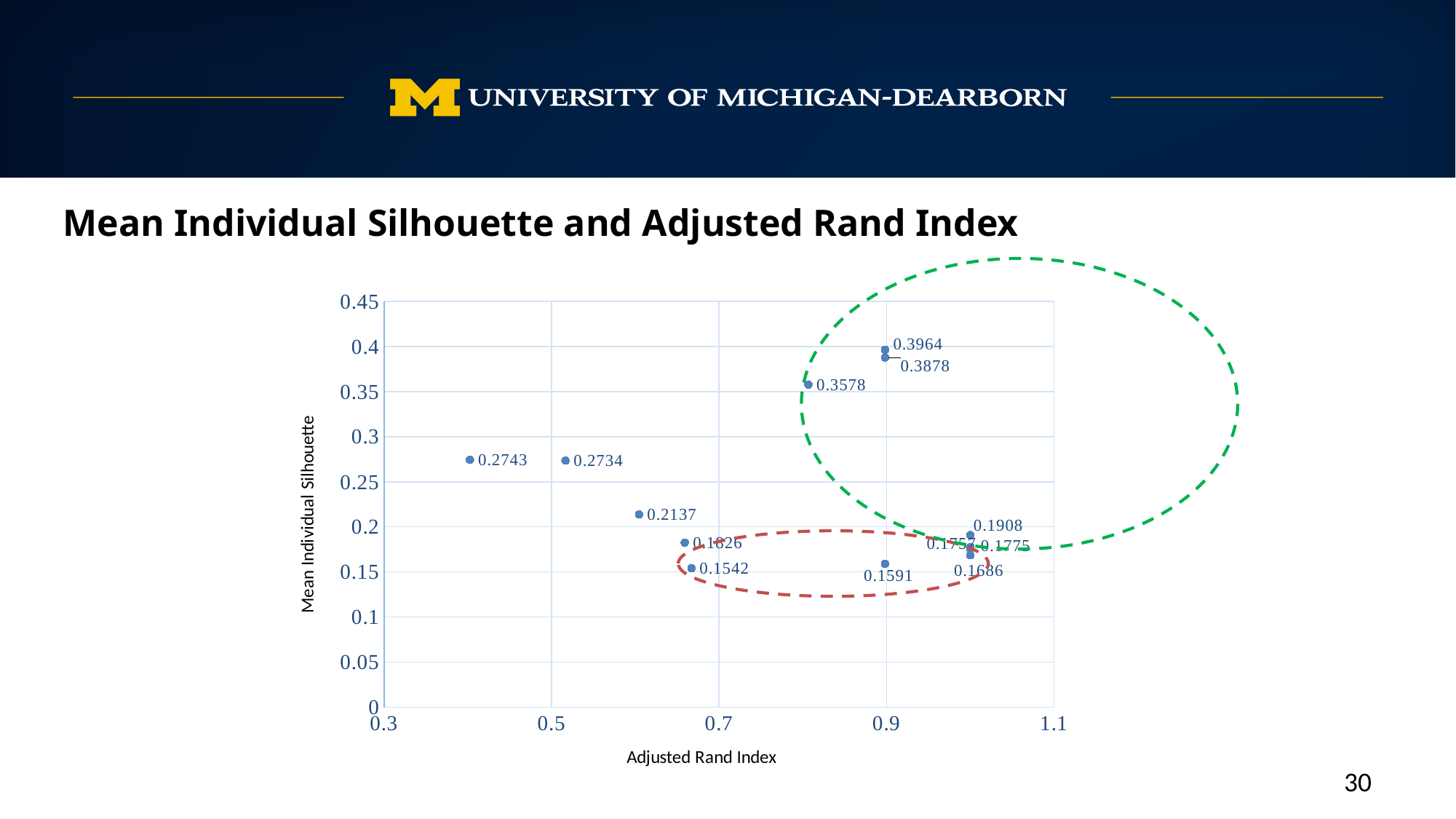
What is the title of the x axis? Adjusted Rand Index What is the highest Mean Individual Silhouette value labelled on the chart? 0.3964 Is the Adjusted Rand Index of the point labelled 0.3578 greater or less than 0.9? less What is the lowest Mean Individual Silhouette value labelled on the chart? 0.1542 Is the Adjusted Rand Index of the point labelled 0.2743 greater or less than 0.5? less Is the Adjusted Rand Index of the point labelled 0.1908 greater or less than 0.9? greater What is the difference between the two highest labelled values, 0.3964 and 0.3878? 0.0086 What kind of chart is shown on the slide? scatter chart How many labelled points have a Mean Individual Silhouette value above 0.35? 3 Which labelled value is larger, 0.2743 or 0.2734? 0.2743 How many data points are plotted on the chart? 13 What is the title of the y axis? Mean Individual Silhouette